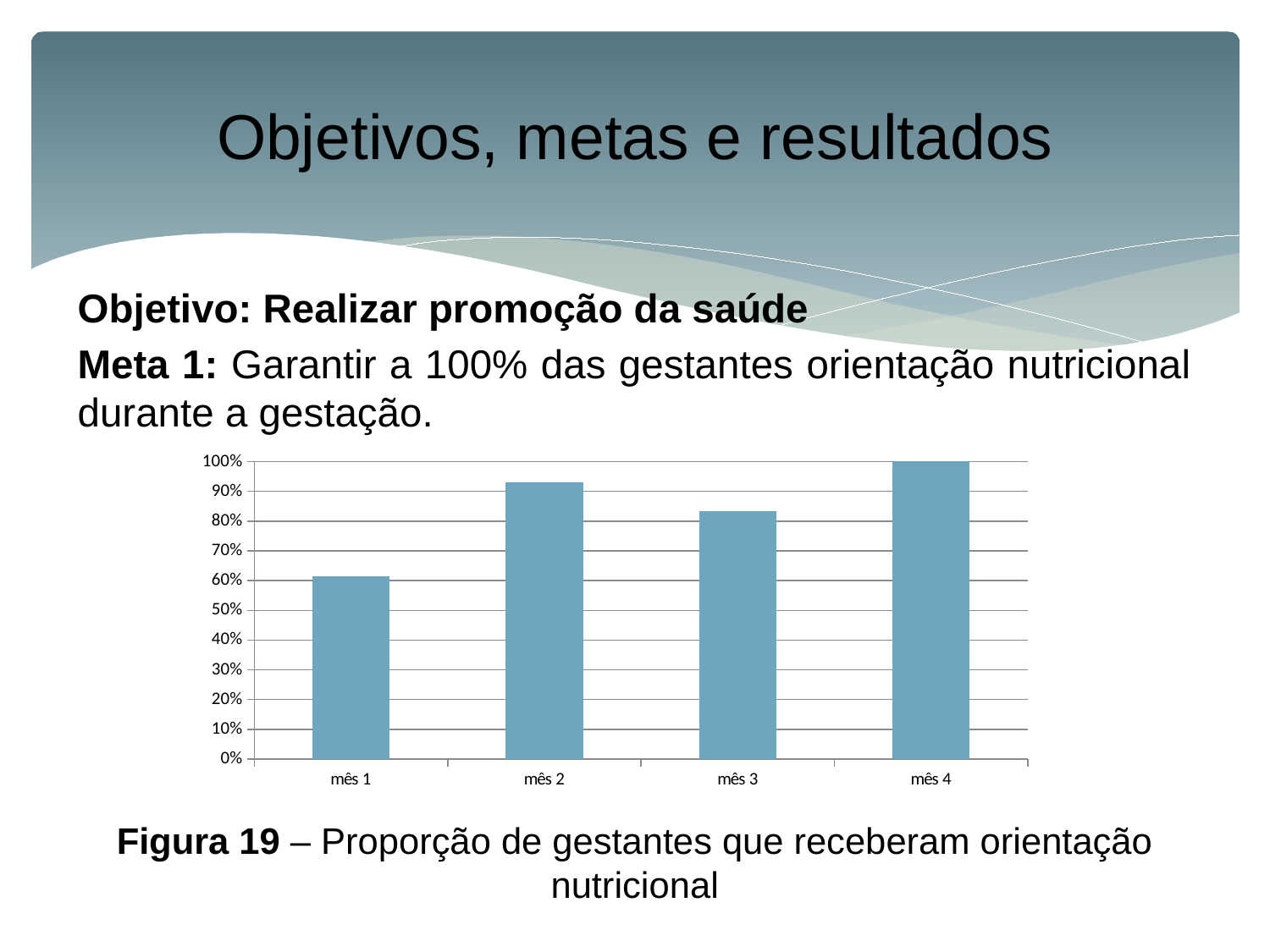
Does the value rise or fall from mês 1 to mês 2? rise Is the value for mês 1 greater or less than 50%? greater Which is larger, the value for mês 2 or the value for mês 3? mês 2 What is the figure caption given below the chart? Figura 19 – Proporção de gestantes que receberam orientação nutricional Is the value for mês 3 greater or less than 90%? less Is the value for mês 1 greater or less than 70%? less How many months (categories) are shown on the x axis of the chart? 4 Which month has the lowest value in the chart? mês 1 Which month has the highest value in the chart? mês 4 What is the value for mês 4 in the chart? 100% What kind of chart is shown on the slide? bar chart